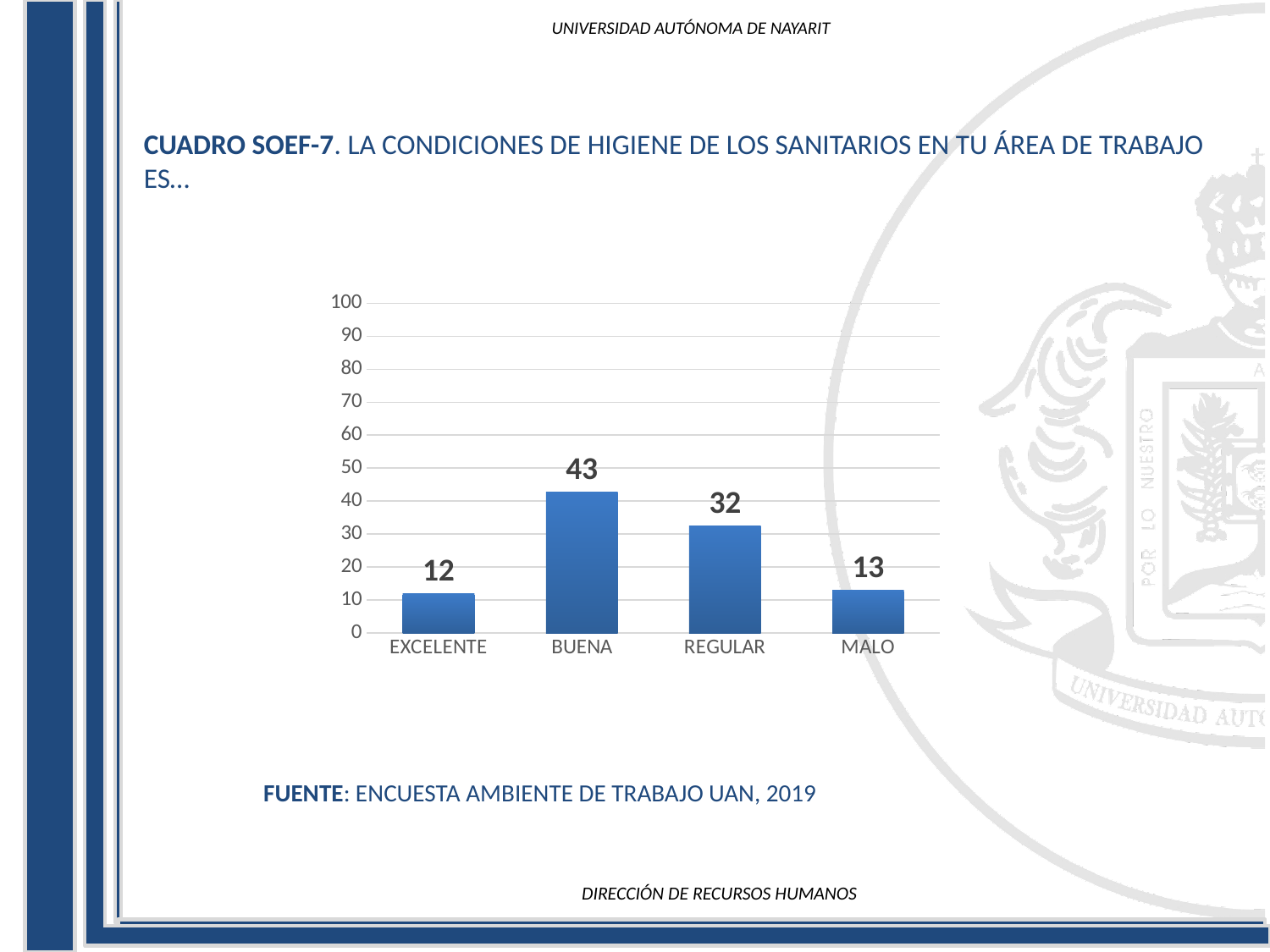
Which category has the highest value? BUENA What kind of chart is shown on the slide? bar chart What is the highest value shown on the y axis? 100 What is the value for BUENA? 43 Which is larger, the value for REGULAR or the value for MALO? REGULAR How many categories are shown on the x axis? 4 What is the value for EXCELENTE? 12 What is the value for MALO? 13 What is the difference between the values for BUENA and REGULAR? 11 What source is cited below the chart? ENCUESTA AMBIENTE DE TRABAJO UAN, 2019 Is the value for REGULAR greater or less than 40? less Which category has the lowest value? EXCELENTE